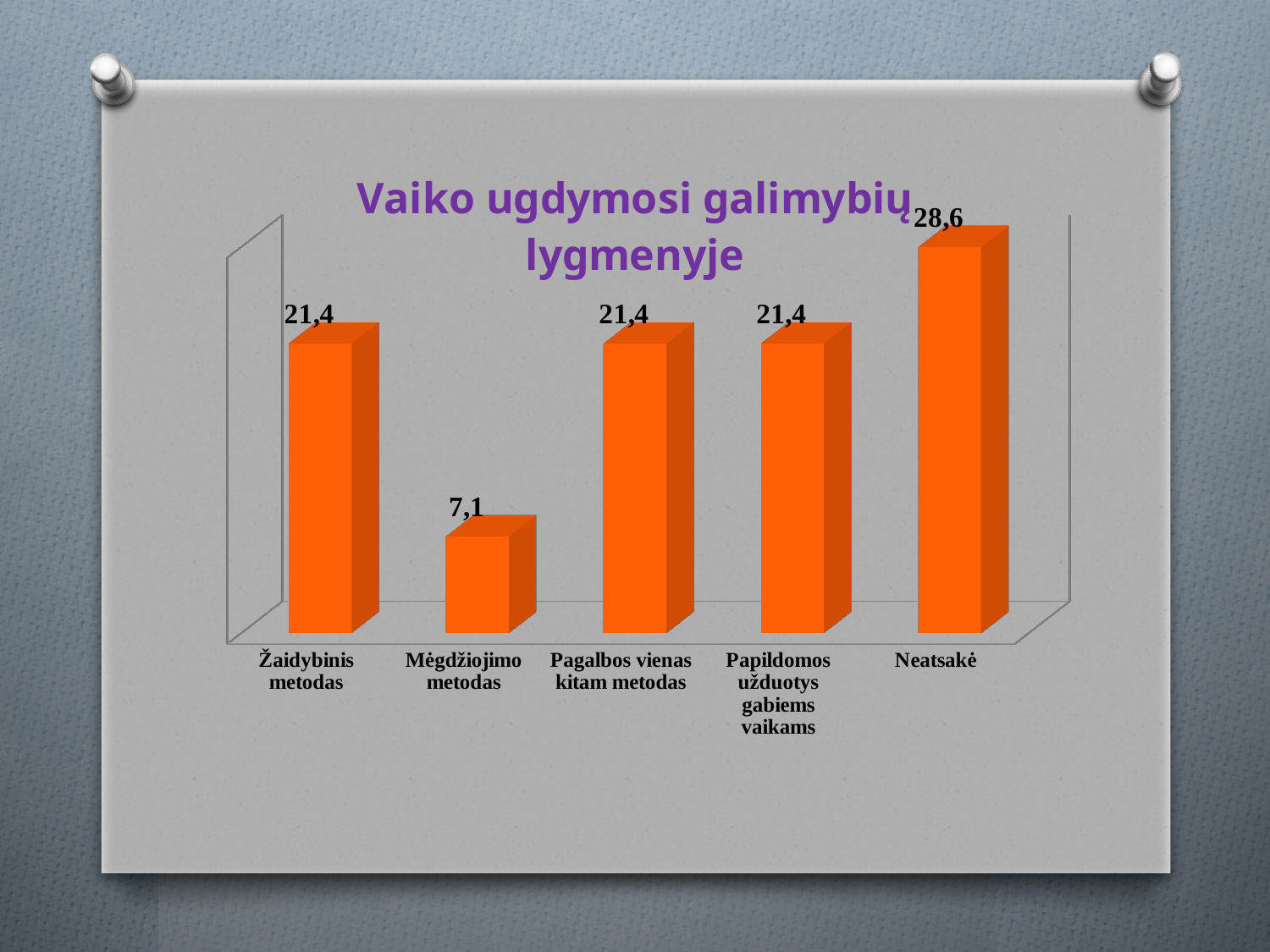
Which is larger, the value for Neatsakė or the value for Žaidybinis metodas? Neatsakė What is the value for Papildomos užduotys gabiems vaikams? 21,4 Which category has the highest value? Neatsakė What is the value for Mėgdžiojimo metodas? 7,1 What colour are the bars in the chart? Orange What is the difference between the values for Pagalbos vienas kitam metodas and Mėgdžiojimo metodas? 14,3 What is the value for Žaidybinis metodas? 21,4 How many categories are shown in the chart? 5 What kind of chart is shown on the slide? Bar chart What is the difference between the values for Neatsakė and Mėgdžiojimo metodas? 21,5 Which category has the lowest value? Mėgdžiojimo metodas What is the value for Neatsakė? 28,6